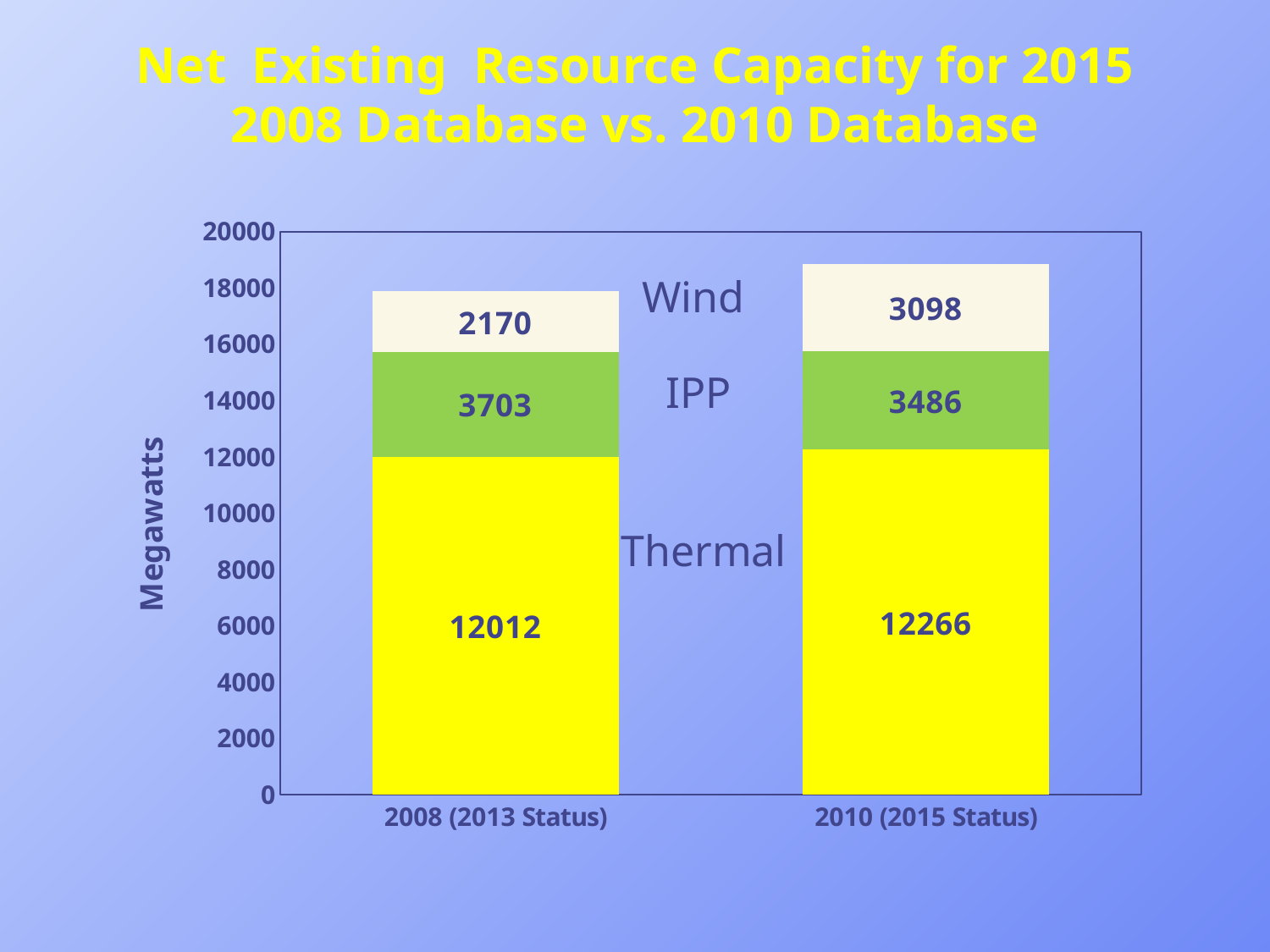
What is the difference between the Thermal values for 2010 (2015 Status) and 2008 (2013 Status)? 254 What is the total stacked value for the 2008 (2013 Status) bar? 17885 What is the total stacked value for the 2010 (2015 Status) bar? 18850 What is the difference between the Wind values for 2010 (2015 Status) and 2008 (2013 Status)? 928 What is the IPP value for 2010 (2015 Status)? 3486 What is the IPP value for 2008 (2013 Status)? 3703 What kind of chart is shown on the slide? Stacked bar chart What is the Wind value for 2010 (2015 Status)? 3098 What is the label of the y axis? Megawatts Which category has the larger IPP value, 2008 (2013 Status) or 2010 (2015 Status)? 2008 (2013 Status) What is the Thermal value for 2008 (2013 Status)? 12012 How many categories are shown on the x axis? 2